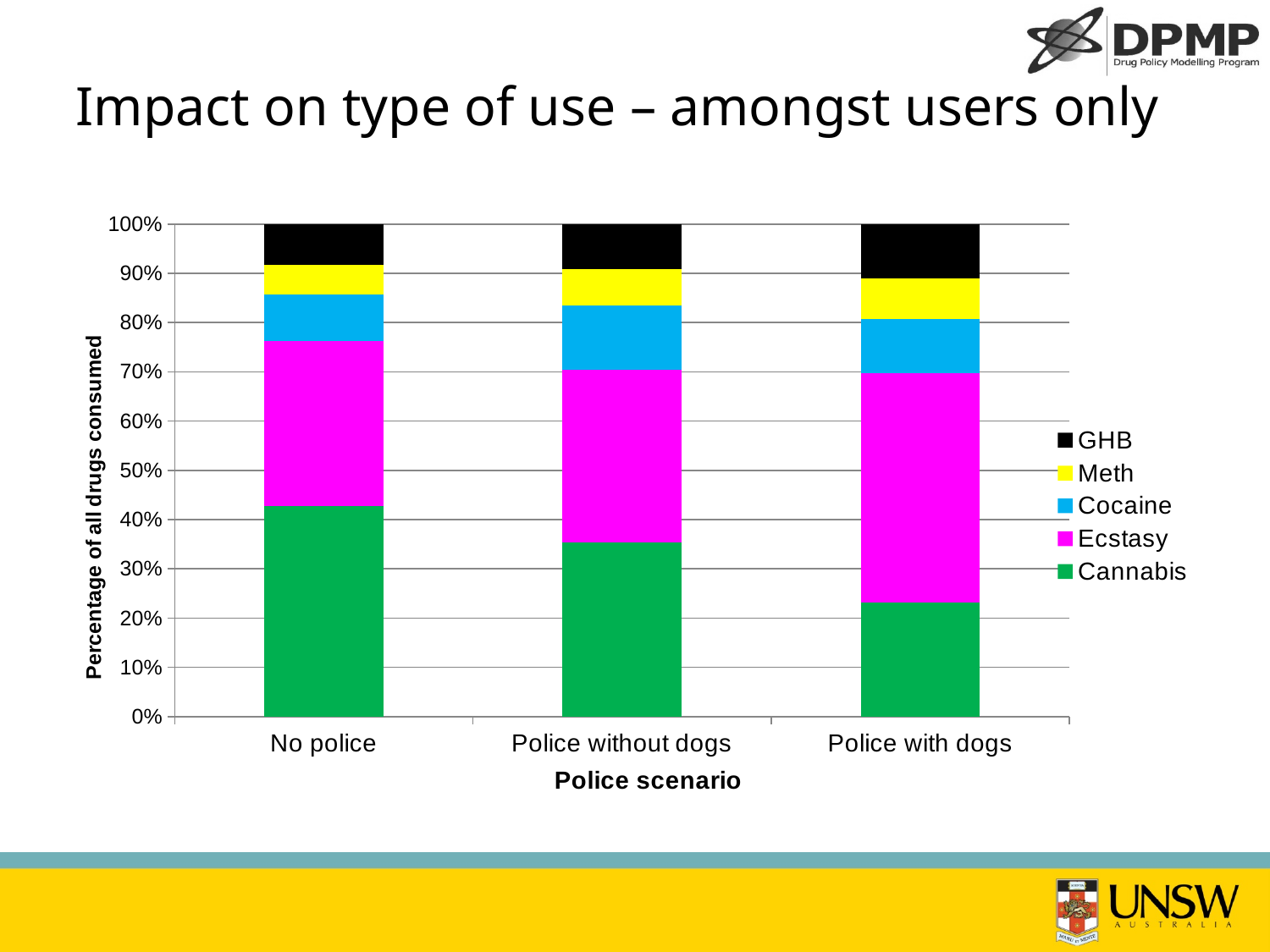
Which police scenario has the smallest Cannabis share? Police with dogs Which police scenario has the largest Cannabis share? No police What is the title of the y axis? Percentage of all drugs consumed Which police scenario has the largest Ecstasy share? Police with dogs How many series does the legend list? 5 How many police scenarios are shown on the x axis? 3 Does the Cannabis share rise or fall moving from No police to Police with dogs? Fall Which is larger, the Cannabis share for Police without dogs or for Police with dogs? Police without dogs What kind of chart is shown on the slide? Stacked bar chart Is the Cannabis share for Police with dogs greater or less than 30%? less What is the total height of each stacked bar? 100% Is the Cannabis share for No police greater or less than 40%? greater